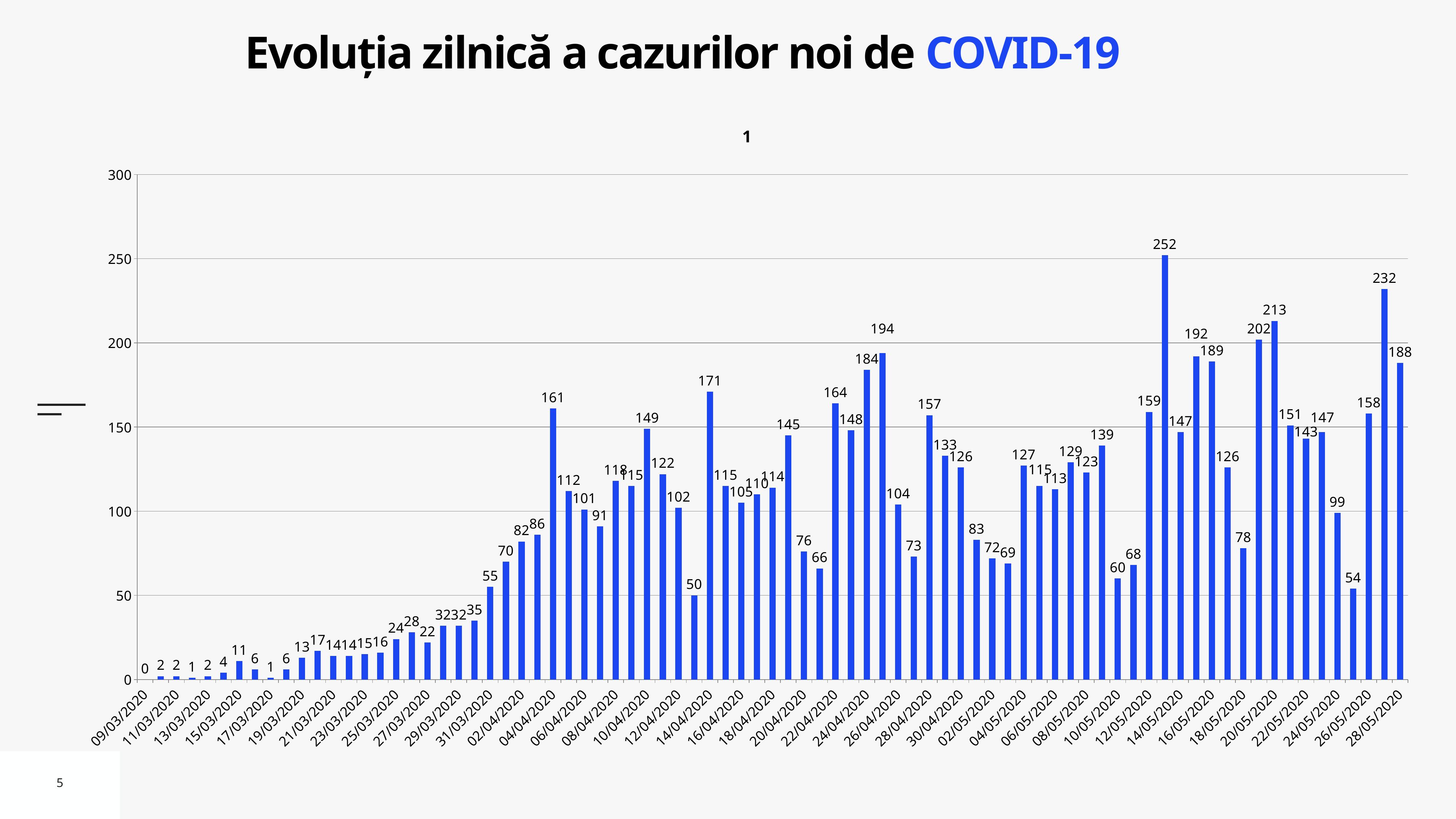
What is the value for 10/05/2020? 60 Do the values generally rise or fall from 09/03/2020 to 28/05/2020? rise What is the highest value shown on the chart? 252 Which date has the lowest value on the chart? 09/03/2020 Is the value for 18/05/2020 greater or less than 100? less What is the value for 20/05/2020? 213 What is the difference between the values for 28/05/2020 and 26/05/2020? 30 What is the value for 14/04/2020? 171 What kind of chart is shown on the slide? bar chart What is the value for 28/05/2020? 188 Which has a larger value, 22/04/2020 or 24/04/2020? 24/04/2020 What is the title of the slide? Evoluția zilnică a cazurilor noi de COVID-19